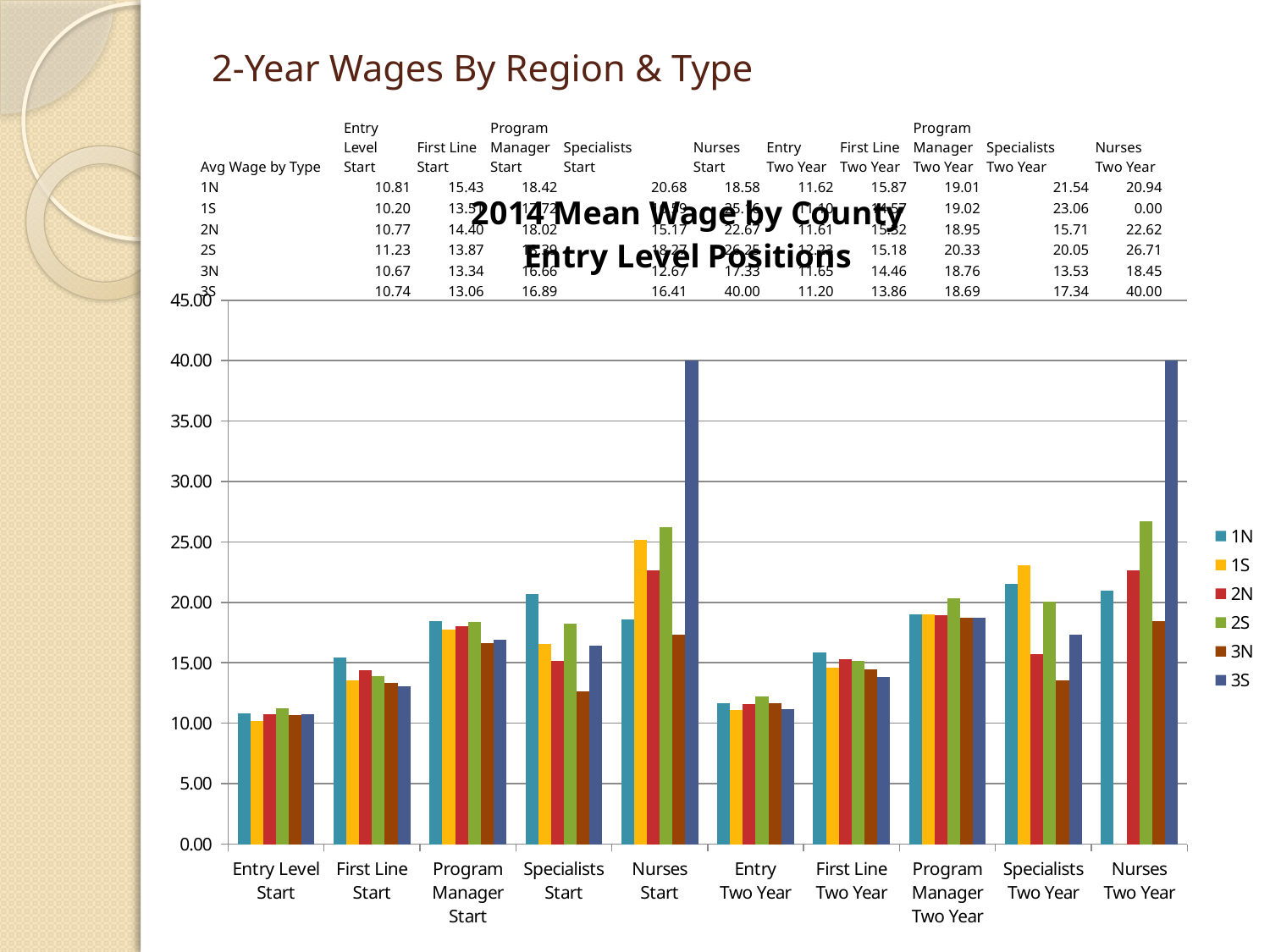
Which series has the highest value in the Nurses Start category? 3S Is the value for 3S in the Nurses Two Year category greater or less than 35.00? greater What is the title of the chart? 2014 Mean Wage by County Entry Level Positions Which series has the lowest value in the Specialists Two Year category? 3N In the Program Manager Two Year category, which is larger: 2S or 1N? 2S What is the difference between the 1N and 3N values in the Specialists Start category? 8.01 What is the value for 1N in the Entry Level Start category? 10.81 What is the value for 3S in the Nurses Start category? 40.00 How many series does the legend list? 6 What kind of chart is shown on the slide? bar chart How many categories are shown along the x axis? 10 What is the value for 3N in the Specialists Two Year category? 13.53